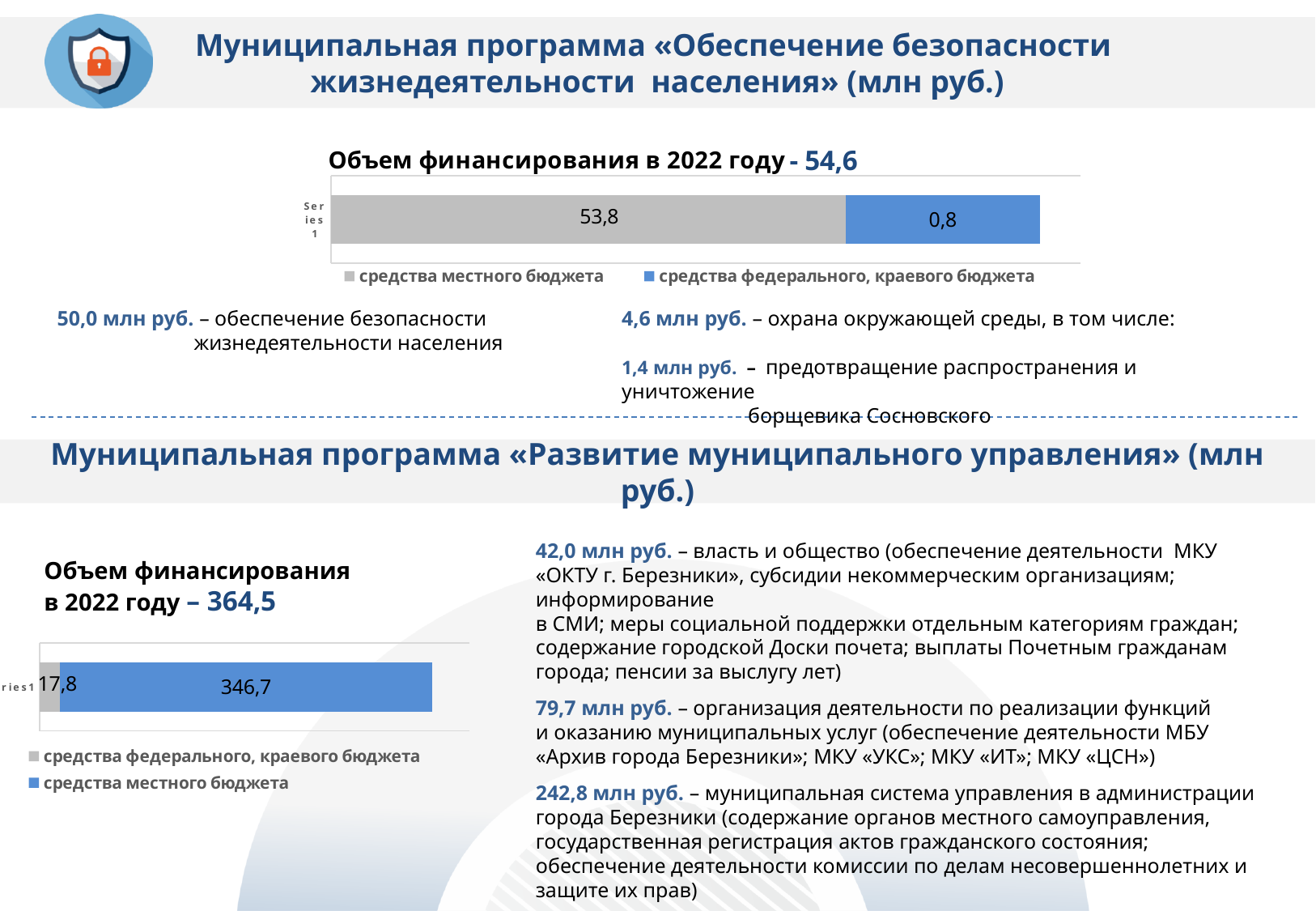
In the top chart (Объем финансирования в 2022 году - 54,6), what is the value for средства местного бюджета? 53,8 In the top chart (Объем финансирования в 2022 году - 54,6), what is the value for средства федерального, краевого бюджета? 0,8 In the bottom chart, what is the difference between средства местного бюджета and средства федерального, краевого бюджета? 328,9 What kind of chart is the top chart? Stacked bar chart In the top chart, what is the total of the stacked bar? 54,6 In the bottom chart (Объем финансирования в 2022 году – 364,5), what is the value for средства федерального, краевого бюджета? 17,8 In the top chart, what is the difference between средства местного бюджета and средства федерального, краевого бюджета? 53,0 In the bottom chart, what is the total of the stacked bar? 364,5 In the top chart, which series has the larger value: средства местного бюджета or средства федерального, краевого бюджета? средства местного бюджета In the bottom chart (Объем финансирования в 2022 году – 364,5), what is the value for средства местного бюджета? 346,7 How many series does the legend of the top chart list? 2 In the bottom chart, which colour represents средства местного бюджета? Blue